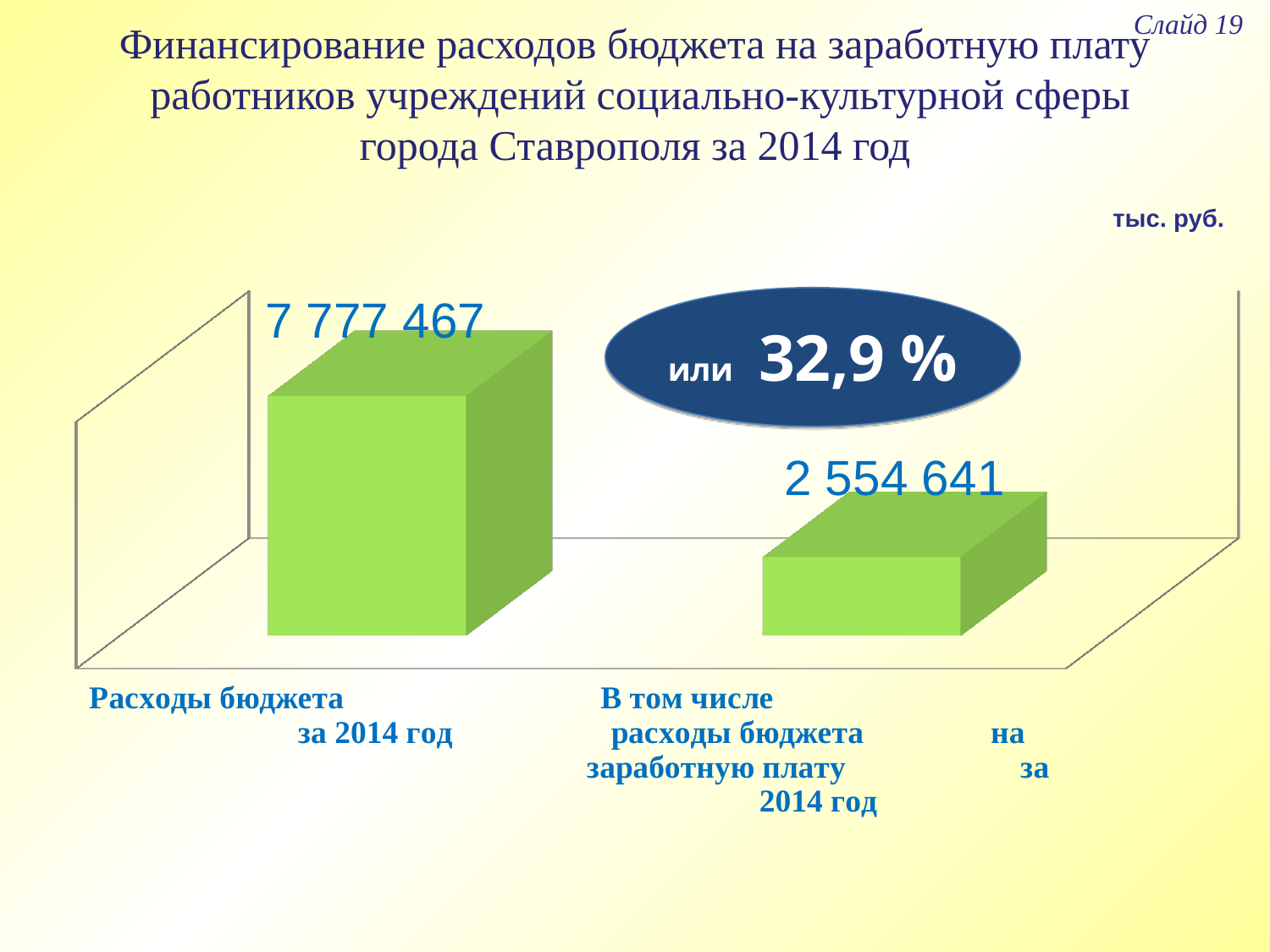
Do the values rise or fall from the left bar to the right bar? Fall What is the difference between «Расходы бюджета за 2014 год» and «В том числе расходы бюджета на заработную плату за 2014 год»? 5 222 826 What percentage is shown in the oval callout on the chart? 32,9 % What kind of chart is shown on the slide? Bar chart Which category has the highest value? Расходы бюджета за 2014 год Which category has the lowest value? В том числе расходы бюджета на заработную плату за 2014 год What unit of measurement is indicated for the chart values? тыс. руб. What is the value for «В том числе расходы бюджета на заработную плату за 2014 год»? 2 554 641 Which is larger: «Расходы бюджета за 2014 год» or «В том числе расходы бюджета на заработную плату за 2014 год»? Расходы бюджета за 2014 год How many bars are shown in the chart? 2 What is the value for «Расходы бюджета за 2014 год»? 7 777 467